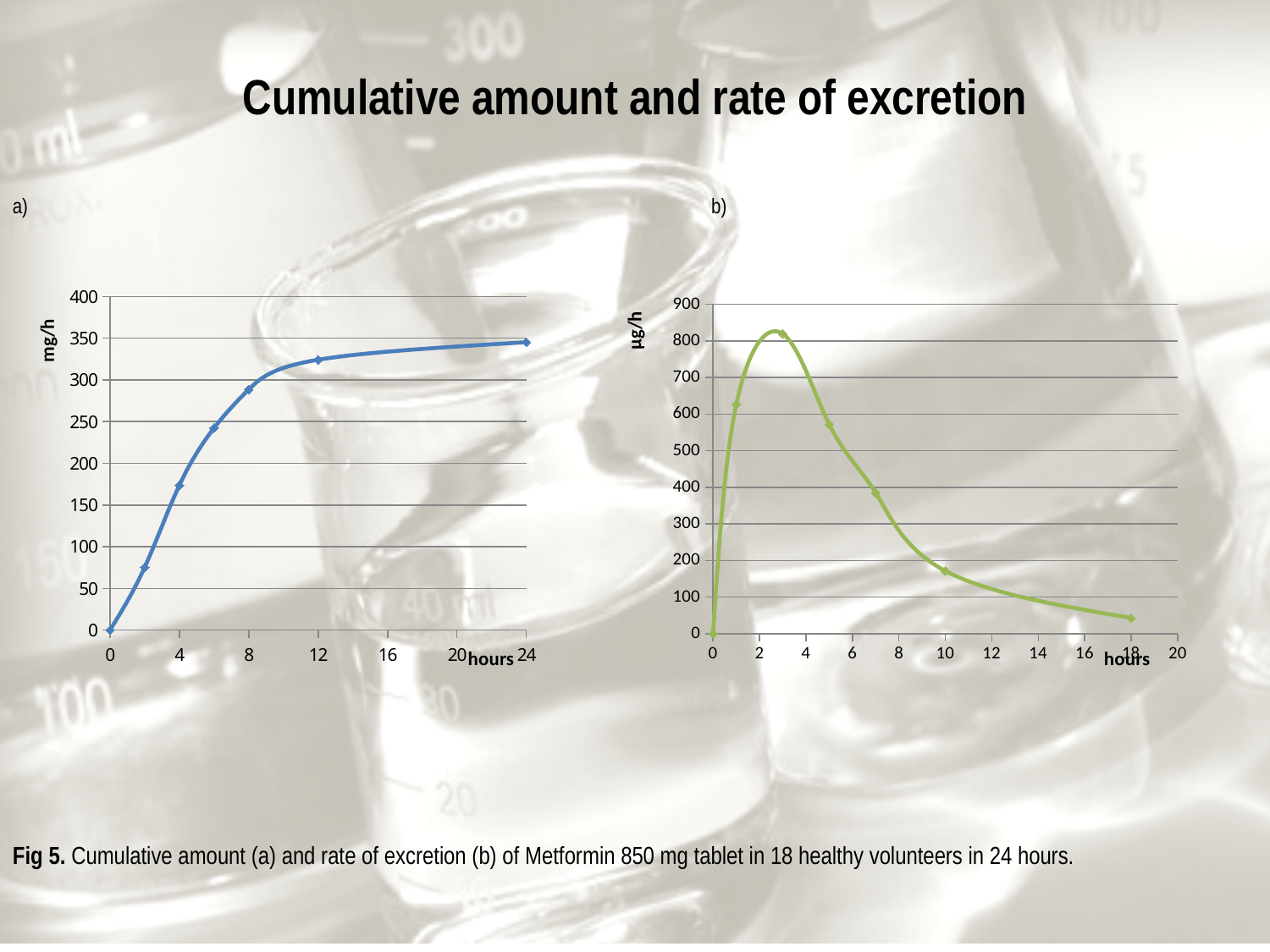
In chart b) on the right, is the value at 18 hours greater or less than 100? less In chart a) on the left, do the values rise or fall as hours increase? rise In chart a) on the left, is the value at 12 hours greater or less than 300? greater In chart b) on the right, is the peak value greater or less than 800? greater In chart a) on the left, at which hour is the plotted value highest? 24 What is the y-axis label of chart b) on the right? µg/h In chart b) on the right, do the values rise or fall after the peak at around 3 hours? fall What kind of chart is chart a) on the left? line chart What kind of chart is chart b) on the right? line chart